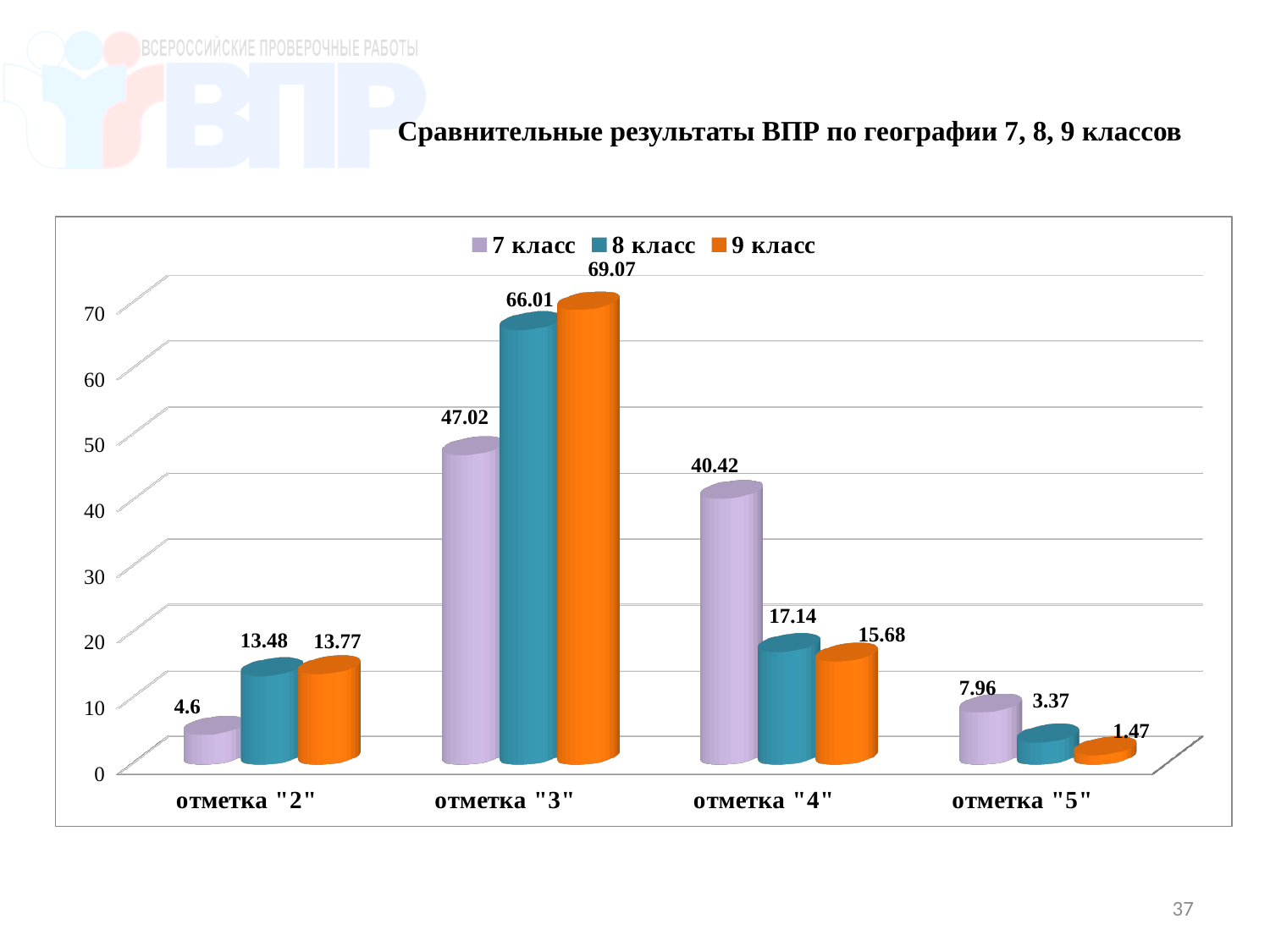
How many categories are shown on the x axis? 4 What kind of chart is shown on the slide? bar chart What is the title of the chart on the slide? Сравнительные результаты ВПР по географии 7, 8, 9 классов What is the difference between the 9 класс and 8 класс values at отметка "3"? 3.06 Which category has the highest value for 9 класс? отметка "3" What is the value for 9 класс at отметка "5"? 1.47 Which category has the lowest value for 7 класс? отметка "2" What is the value for 7 класс at отметка "3"? 47.02 What is the difference between the 7 класс values at отметка "4" and отметка "5"? 32.46 How many series does the legend list? 3 Which is larger at отметка "4": the value for 7 класс or the value for 8 класс? 7 класс What is the value for 8 класс at отметка "4"? 17.14